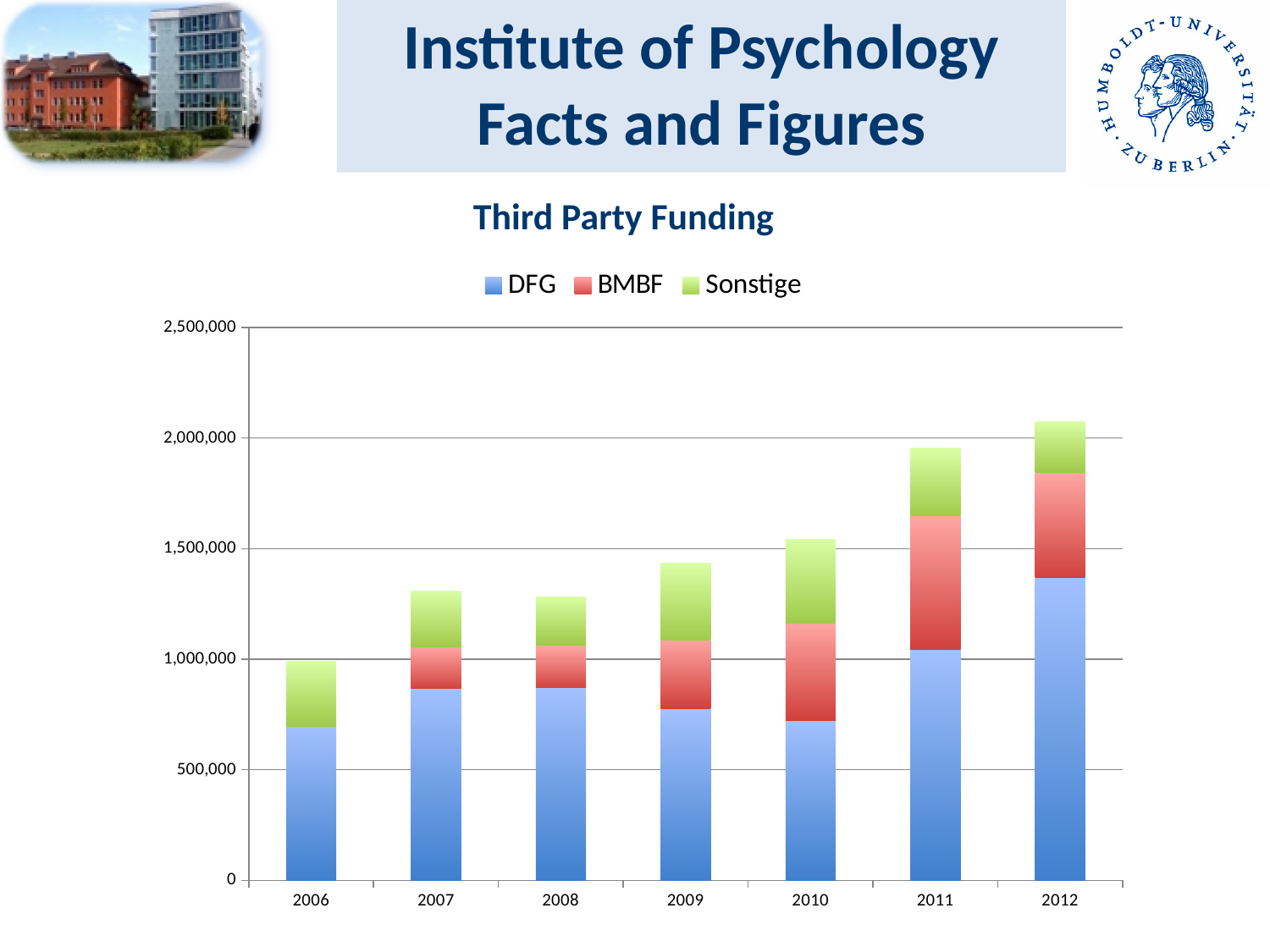
Which year has the lowest total third party funding? 2006 Is the DFG value for 2012 greater or less than 1,000,000? greater How many years are shown on the x axis of the chart? 7 What kind of chart is shown on the slide? Stacked bar chart Which is larger, the DFG value for 2012 or the DFG value for 2011? 2012 How many series does the chart's legend list? 3 What is the title of the chart? Third Party Funding Overall, does total third party funding rise or fall from 2006 to 2012? rise Is the DFG value for 2010 greater or less than 1,000,000? less Is the total funding for 2012 greater or less than 2,000,000? greater What are the three series listed in the chart's legend? DFG, BMBF, Sonstige Which year has the highest total third party funding? 2012